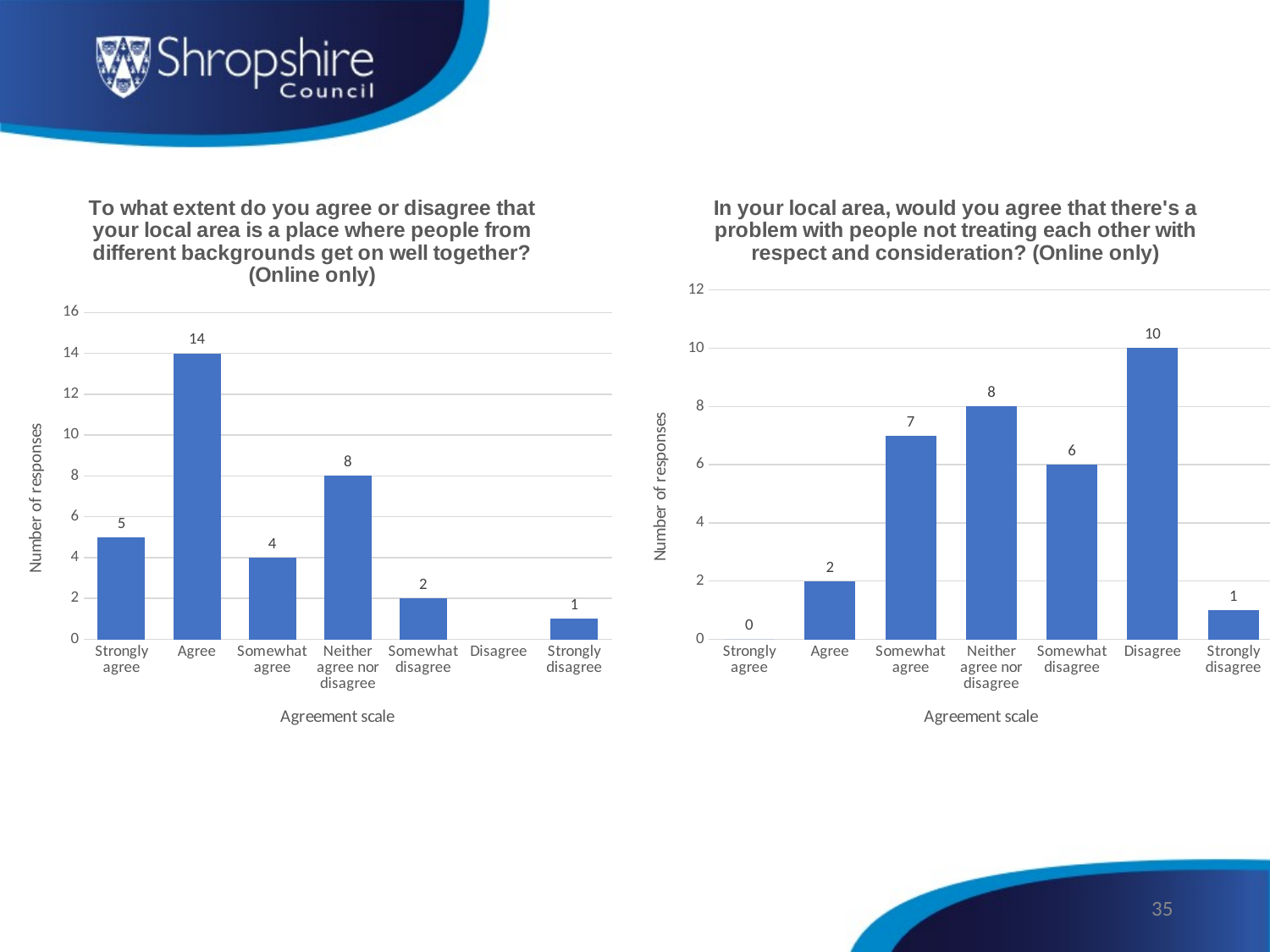
In the left chart about people from different backgrounds getting on well together, what is the difference between the 'Agree' and 'Neither agree nor disagree' responses? 6 In the left chart about people from different backgrounds getting on well together, which agreement category has the highest number of responses? Agree In the left chart about people from different backgrounds getting on well together, how many responses were 'Agree'? 14 In the right chart about people not treating each other with respect and consideration, how many responses were 'Strongly agree'? 0 In the left chart about people from different backgrounds getting on well together, how many responses were 'Somewhat disagree'? 2 In the right chart about people not treating each other with respect and consideration, which agreement category has the highest number of responses? Disagree In the left chart about people from different backgrounds getting on well together, is the value for 'Strongly agree' greater or less than 4? greater What type of chart is the left chart about people from different backgrounds getting on well together? Bar chart In the right chart about people not treating each other with respect and consideration, which is larger: 'Somewhat agree' or 'Somewhat disagree'? Somewhat agree What is the y-axis label of the right chart about people not treating each other with respect and consideration? Number of responses In the right chart about people not treating each other with respect and consideration, how many agreement categories are shown on the x axis? 7 In the right chart about people not treating each other with respect and consideration, what is the difference between 'Disagree' and 'Neither agree nor disagree'? 2